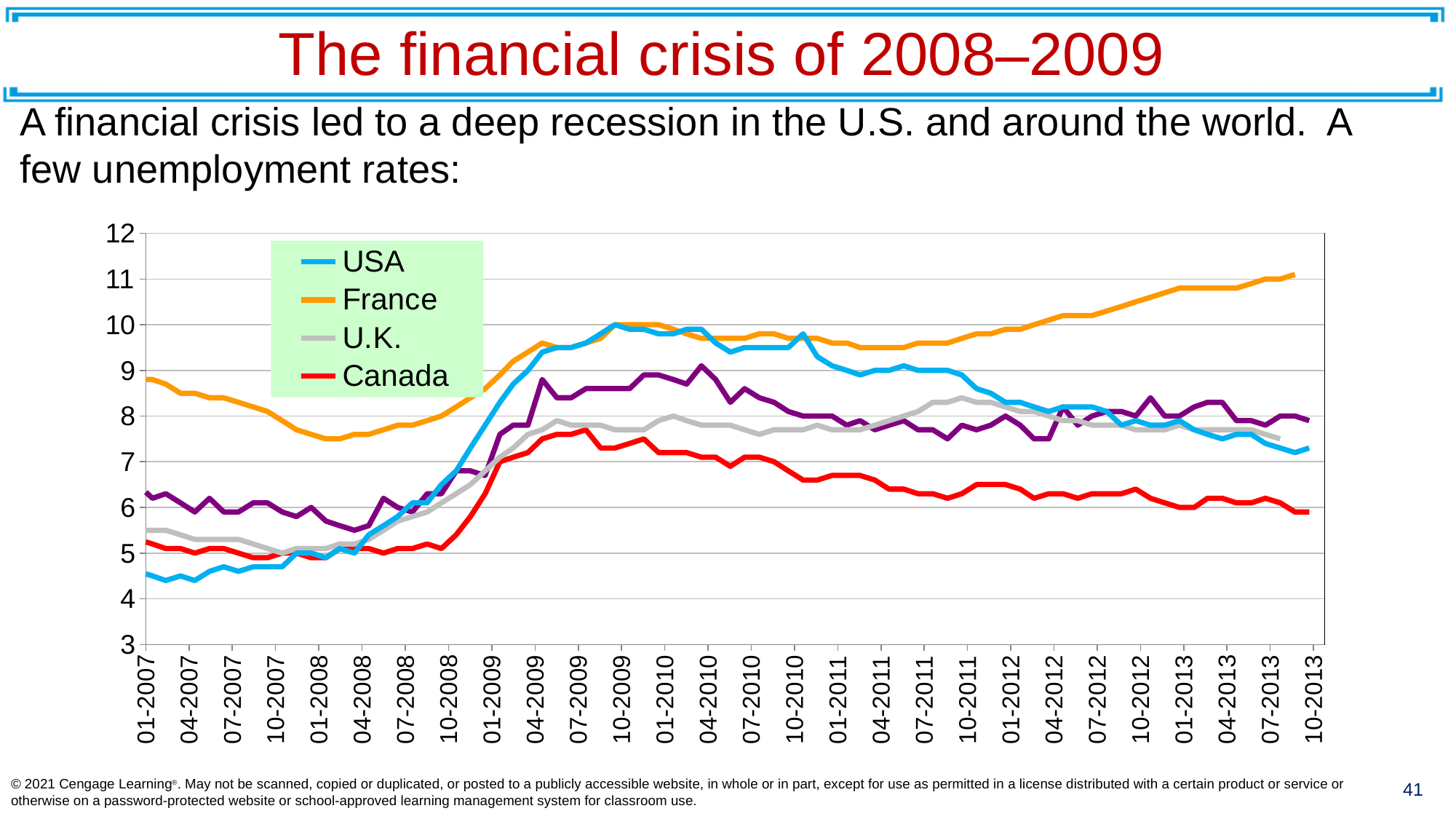
Is the value for USA at 01-2007 greater or less than 5? less Which countries are listed in the chart's legend? USA, France, U.K., Canada Which series is lowest at 01-2007? USA Is the value for France at 01-2008 greater or less than 8? less What kind of chart is shown on the slide? line chart How many series does the chart's legend list? 4 Is the value for Canada at 10-2013 greater or less than 7? less Which series is lowest at 10-2013? Canada Does the France series rise or fall between 01-2011 and 10-2013? rise